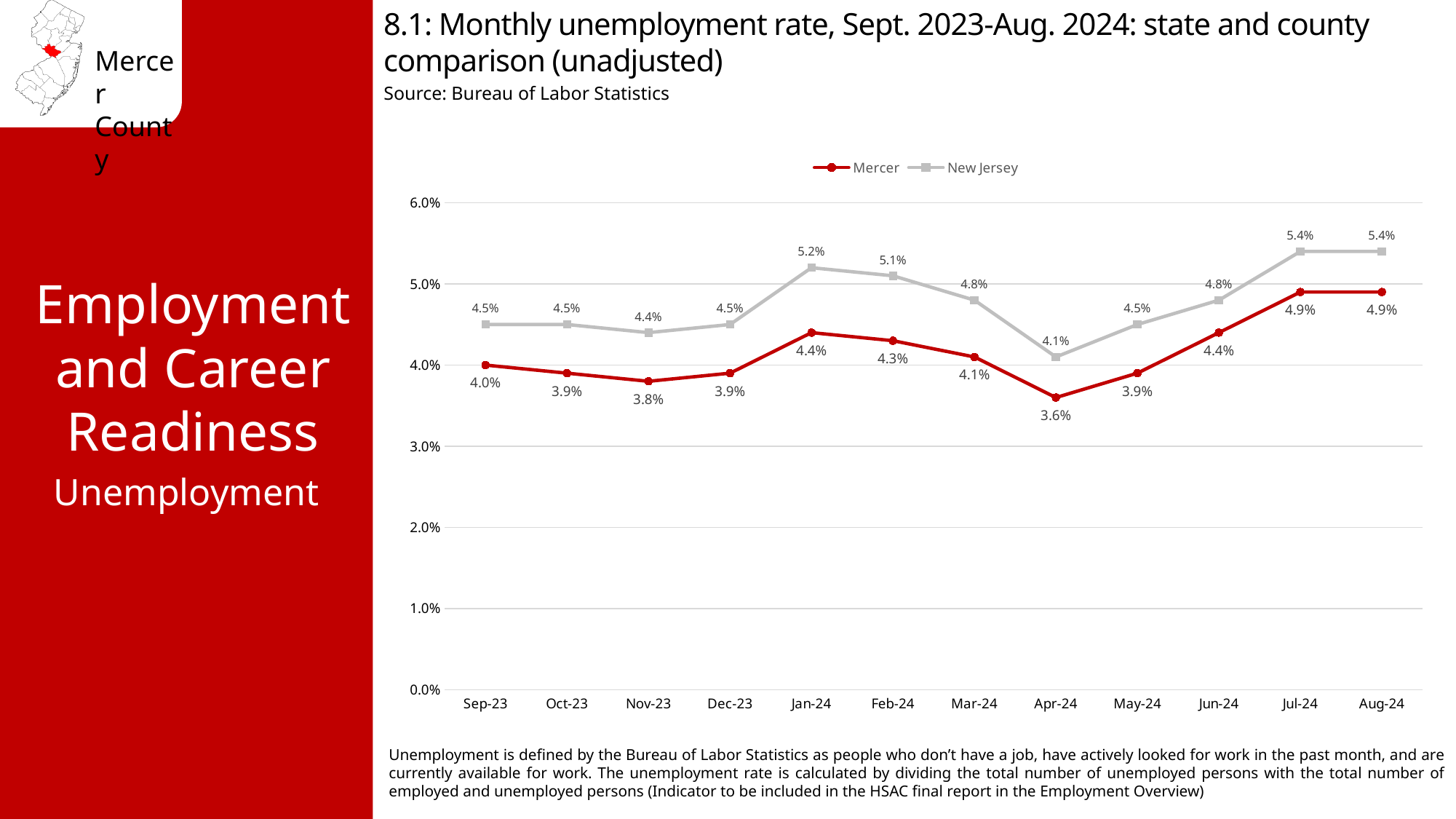
Is the Mercer unemployment rate in Jul-24 greater or less than 5.0%? less In which month was the New Jersey unemployment rate lowest? Apr-24 Which had the higher unemployment rate in Mar-24, Mercer or New Jersey? New Jersey What was the Mercer unemployment rate in Apr-24? 3.6% What is the source cited for the chart? Bureau of Labor Statistics What is the difference between the New Jersey and Mercer unemployment rates in Aug-24? 0.5% What was the New Jersey unemployment rate in Jan-24? 5.2% How many months are shown on the x axis? 12 Did the Mercer unemployment rate rise or fall from Apr-24 to Jul-24? Rise How many series does the legend list? 2 What kind of chart is shown on the slide? Line chart In which month was the Mercer unemployment rate lowest? Apr-24